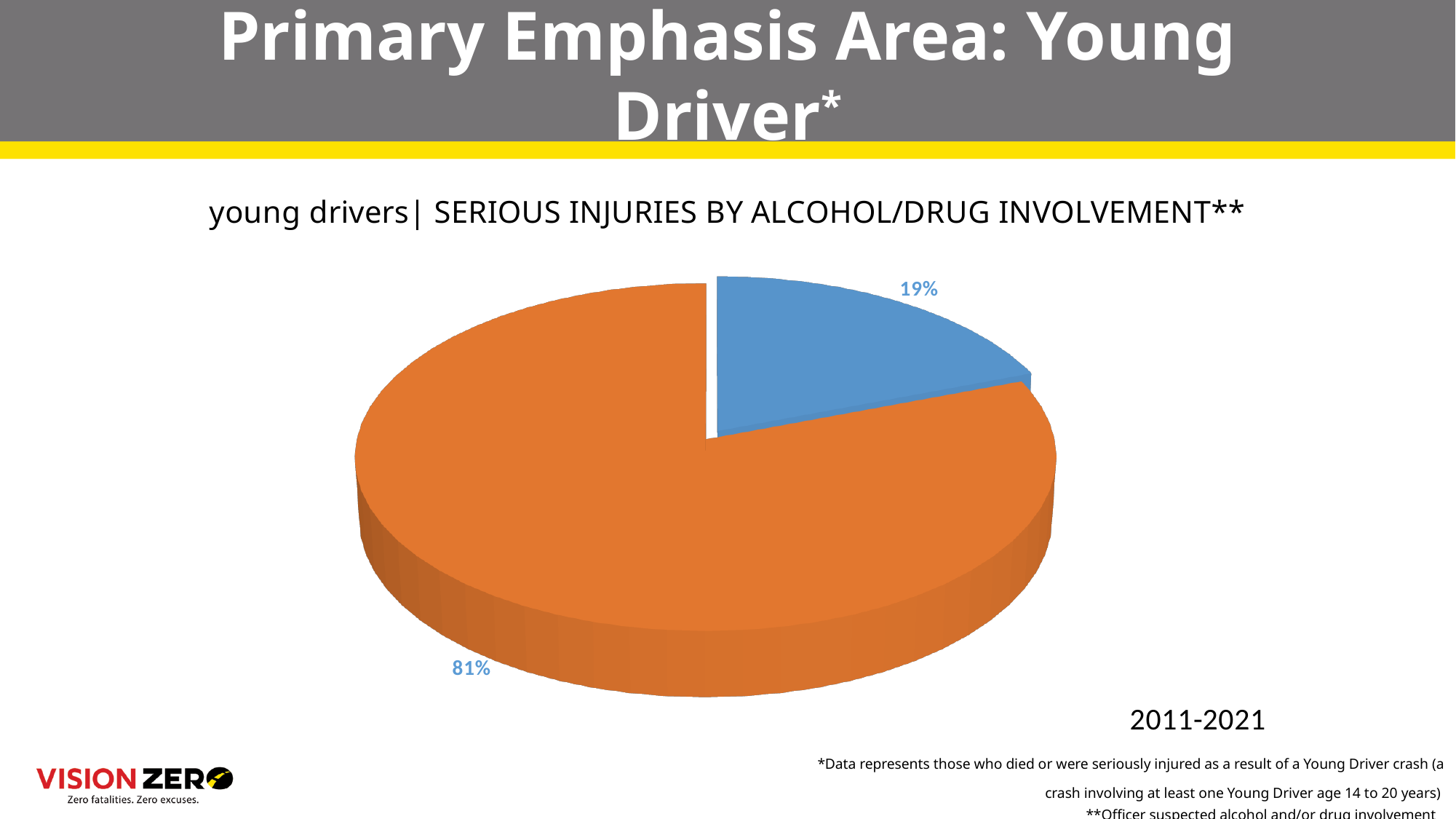
What is the difference in percentage points between the orange slice and the blue slice? 62 What percentage is shown for the blue slice of the pie chart? 19% What percentage is shown for the orange slice of the pie chart? 81% What is the title of the pie chart? young drivers| SERIOUS INJURIES BY ALCOHOL/DRUG INVOLVEMENT** Is the blue slice's share of the pie greater or less than 25%? less Which slice of the pie chart is the smallest, the blue or the orange one? blue What is the combined percentage of the two slices in the pie chart? 100% What time period is shown below the pie chart? 2011-2021 How many slices does the pie chart have? 2 What kind of chart is shown on the slide? pie chart Which slice of the pie chart is the largest, the blue or the orange one? orange